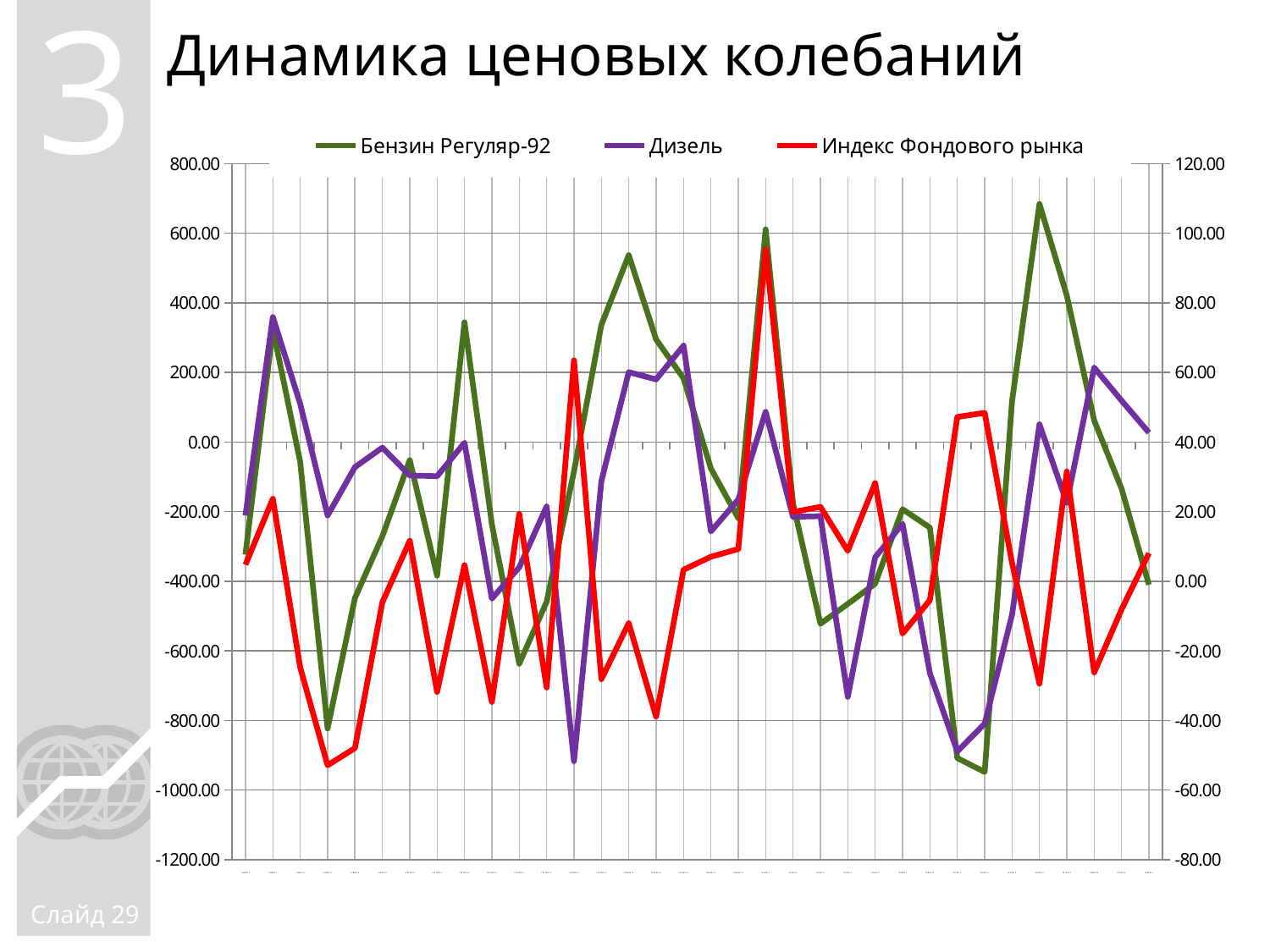
How many series does the legend list? 3 Is the highest point of the Дизель line greater or less than 200.00 on the left axis? greater What is the title of the chart on the slide? Динамика ценовых колебаний Is the highest point of the Бензин Регуляр-92 line greater or less than 600.00 on the left axis? greater Is the lowest point of the Бензин Регуляр-92 line greater or less than -800.00 on the left axis? less What kind of chart is shown on the slide? line chart Which series reaches the highest point on the left axis, Бензин Регуляр-92 or Дизель? Бензин Регуляр-92 Which series is drawn in red? Индекс Фондового рынка